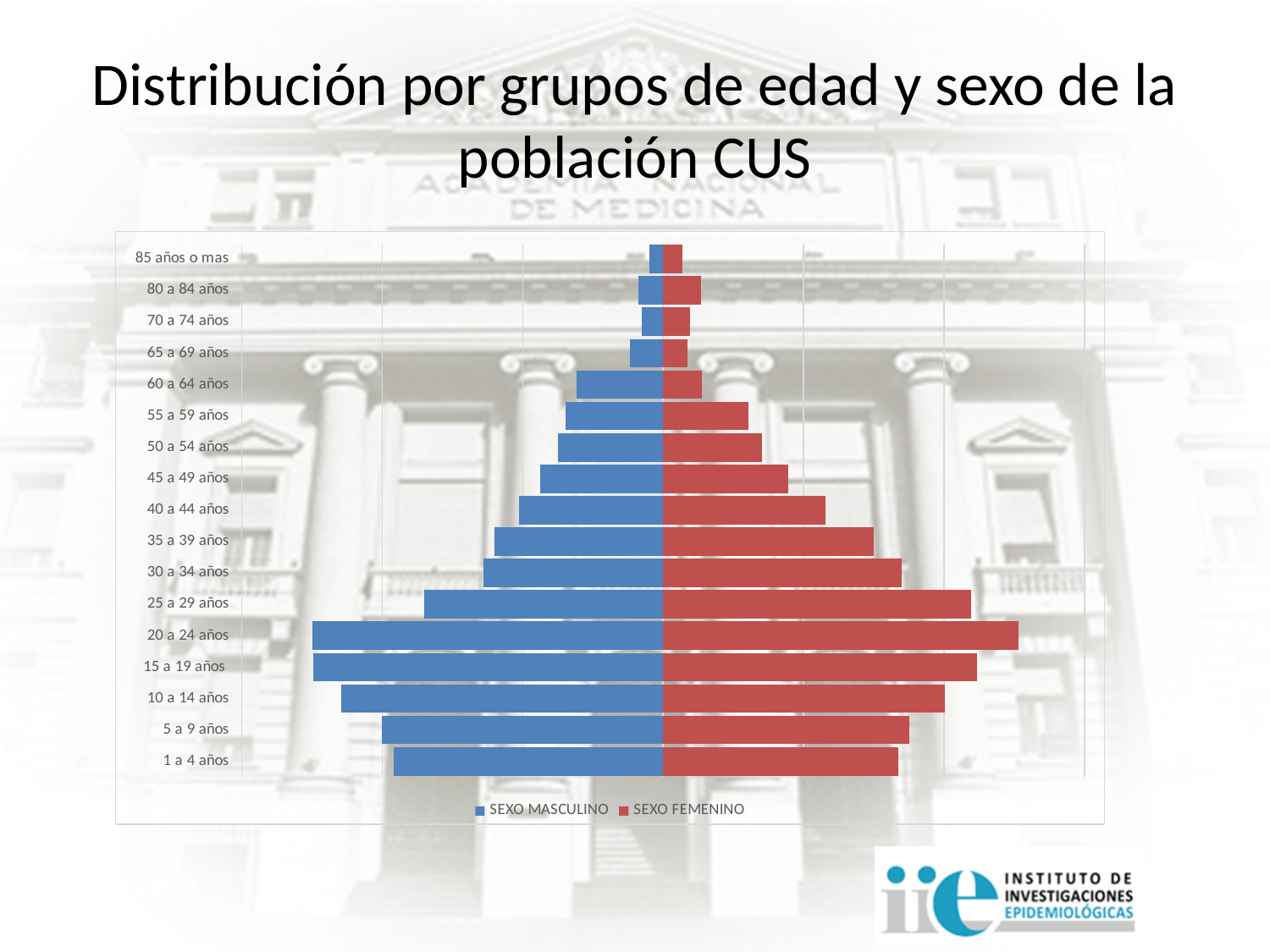
What kind of chart is shown on the slide? Bar chart Moving from the oldest age group (85 años o mas) down to 20 a 24 años, do the bars generally get longer or shorter? Longer For SEXO FEMENINO, which is larger: 25 a 29 años or 55 a 59 años? 25 a 29 años How many age groups are shown on the vertical axis? 17 Which age group has the longest bar for SEXO FEMENINO? 20 a 24 años For SEXO MASCULINO, which is larger: 20 a 24 años or 1 a 4 años? 20 a 24 años How many series does the legend list? 2 For SEXO MASCULINO, which is larger: 30 a 34 años or 40 a 44 años? 30 a 34 años Which colour represents SEXO FEMENINO? Red What are the two series named in the legend? SEXO MASCULINO and SEXO FEMENINO